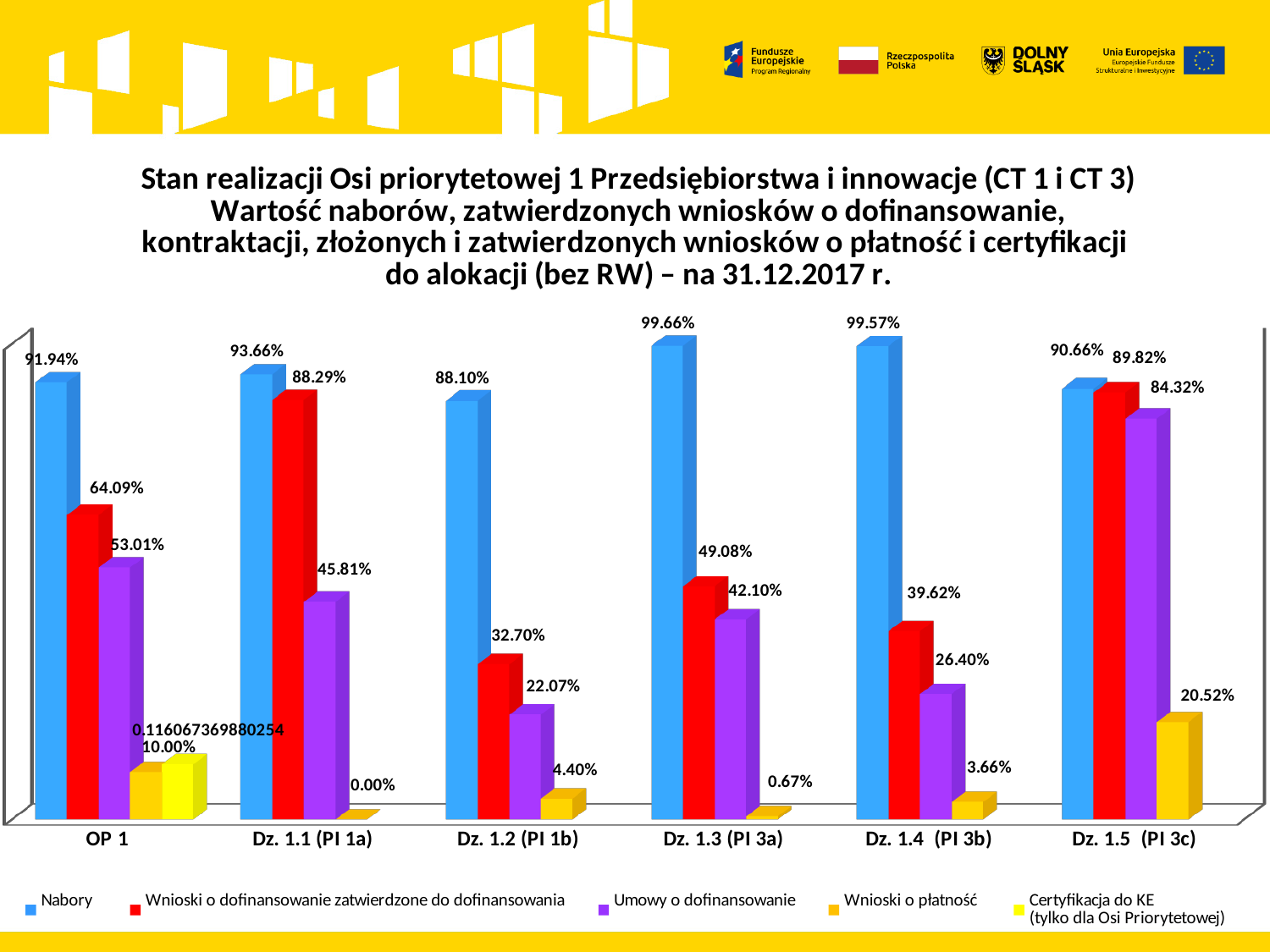
What kind of chart is shown on the slide? Bar chart What is the Nabory value for Dz. 1.3 (PI 3a)? 99.66% How many series does the chart's legend list? 5 What is the value of Wnioski o dofinansowanie zatwierdzone do dofinansowania for Dz. 1.4 (PI 3b)? 39.62% For Dz. 1.1 (PI 1a), what is the difference between the Nabory value and the Wnioski o dofinansowanie zatwierdzone do dofinansowania value? 5.37 percentage points Which category has the highest Wnioski o płatność value? Dz. 1.5 (PI 3c) What is the Certyfikacja do KE value for OP 1? 0.116067369880254 Which has the larger Umowy o dofinansowanie value, Dz. 1.2 (PI 1b) or Dz. 1.4 (PI 3b)? Dz. 1.4 (PI 3b) What is the Umowy o dofinansowanie value for Dz. 1.5 (PI 3c)? 84.32% How many categories are shown along the x axis of the chart? 6 What colour are the Nabory bars in the chart? Blue Which category has the lowest Wnioski o płatność value? Dz. 1.1 (PI 1a)